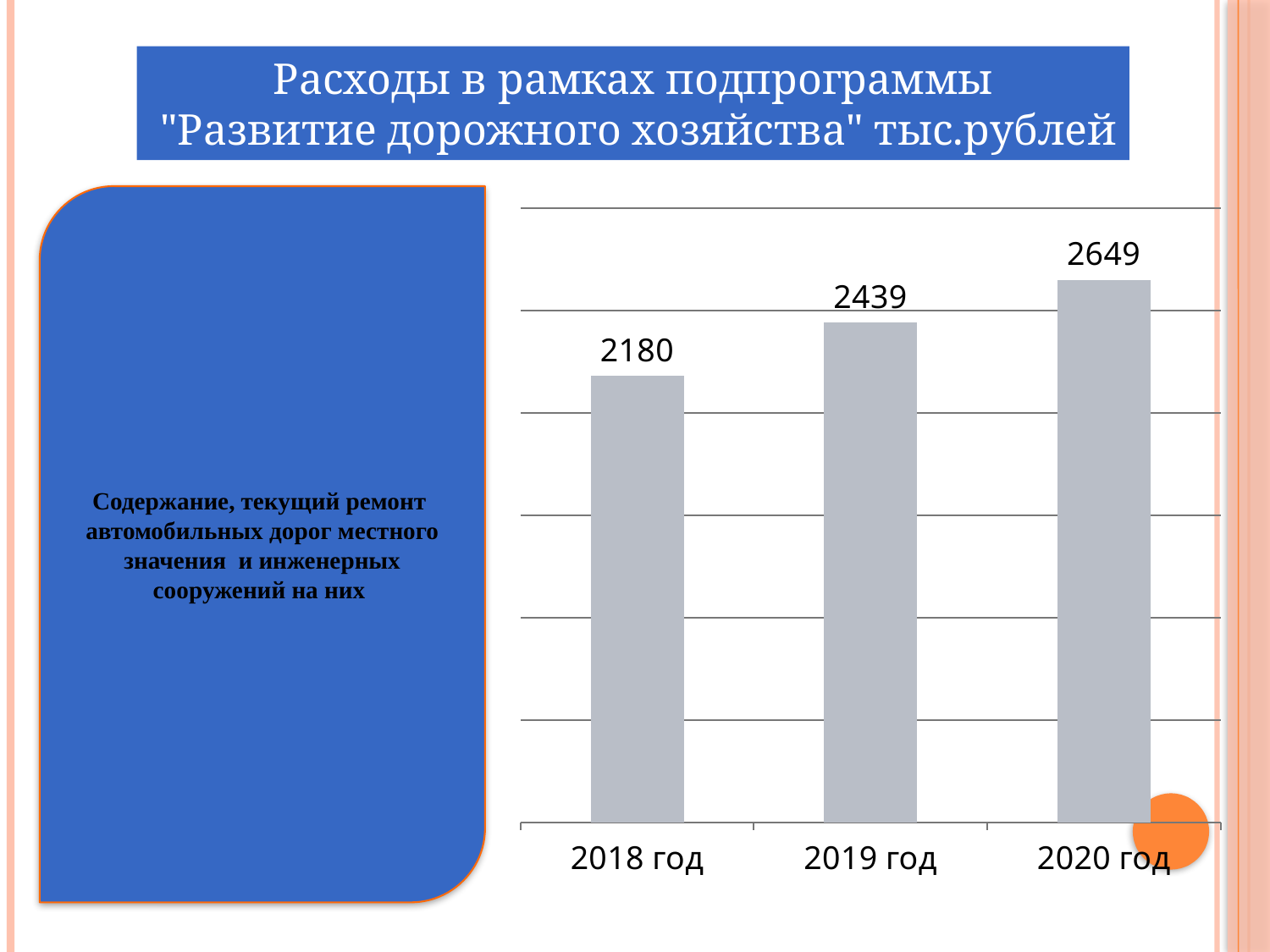
What is the difference between the values for 2019 год and 2018 год? 259 Do the values rise or fall from 2018 год to 2020 год? rise What is the value for 2019 год? 2439 What is the value for 2018 год? 2180 Which is larger, the value for 2019 год or the value for 2020 год? 2020 год How many years are shown on the chart? 3 Which year has the lowest value? 2018 год What is the difference between the values for 2020 год and 2018 год? 469 What is the value for 2020 год? 2649 Which year has the highest value? 2020 год What kind of chart is shown on the slide? bar chart What unit is given in the chart title? тыс.рублей